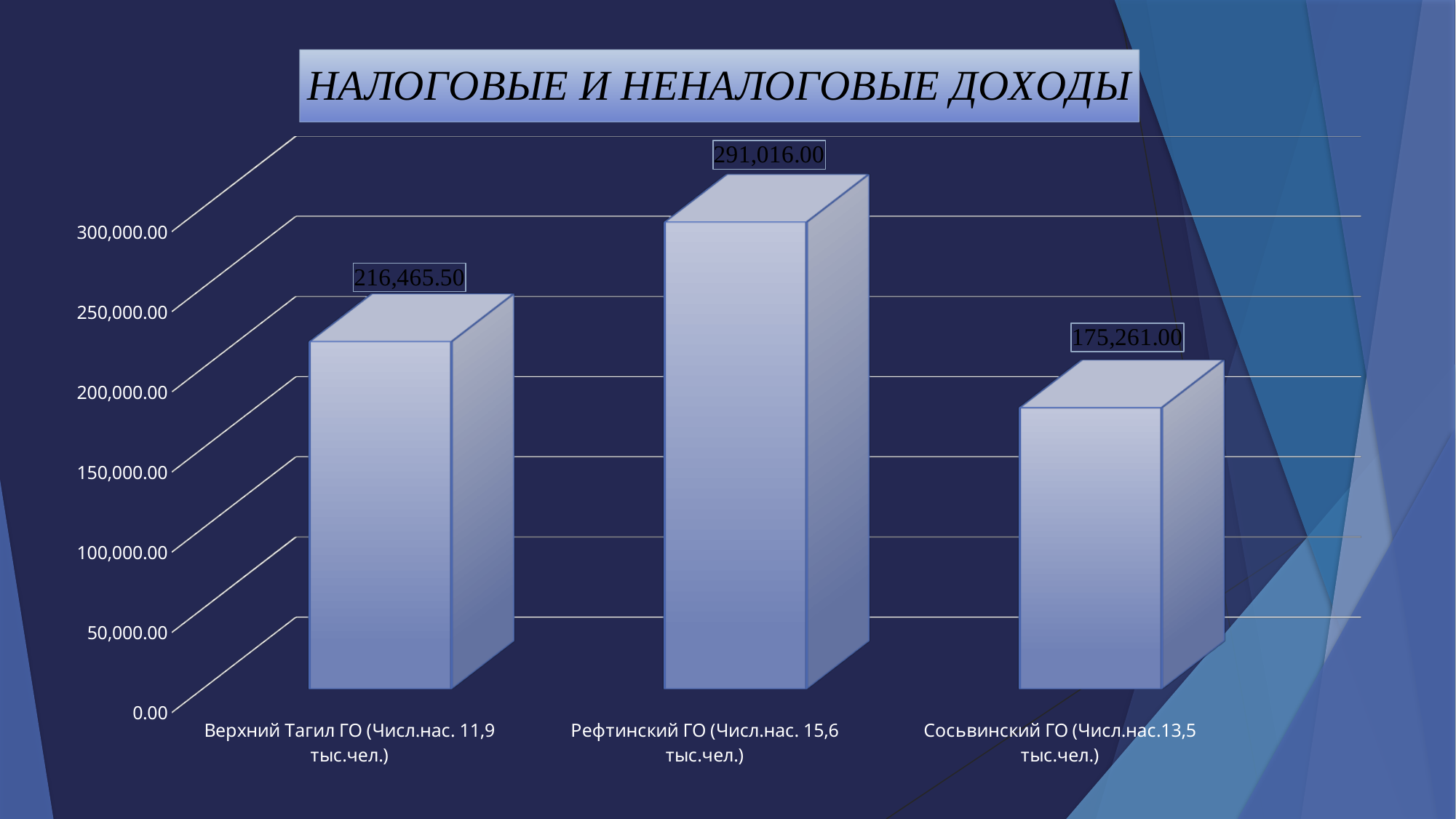
What is the title of the chart? НАЛОГОВЫЕ И НЕНАЛОГОВЫЕ ДОХОДЫ What is the difference between the values for Рефтинский ГО and Верхний Тагил ГО? 74,550.50 Which category has the highest value? Рефтинский ГО What is the difference between the values for Верхний Тагил ГО and Сосьвинский ГО? 41,204.50 Is the value for Сосьвинский ГО greater or less than 200,000.00? less What is the value shown for Сосьвинский ГО? 175,261.00 What kind of chart is shown on the slide? Bar chart What is the value shown for Рефтинский ГО? 291,016.00 Which category has the lowest value? Сосьвинский ГО How many categories are shown in the chart? 3 Which is larger, the value for Верхний Тагил ГО or the value for Сосьвинский ГО? Верхний Тагил ГО What is the value shown for Верхний Тагил ГО? 216,465.50